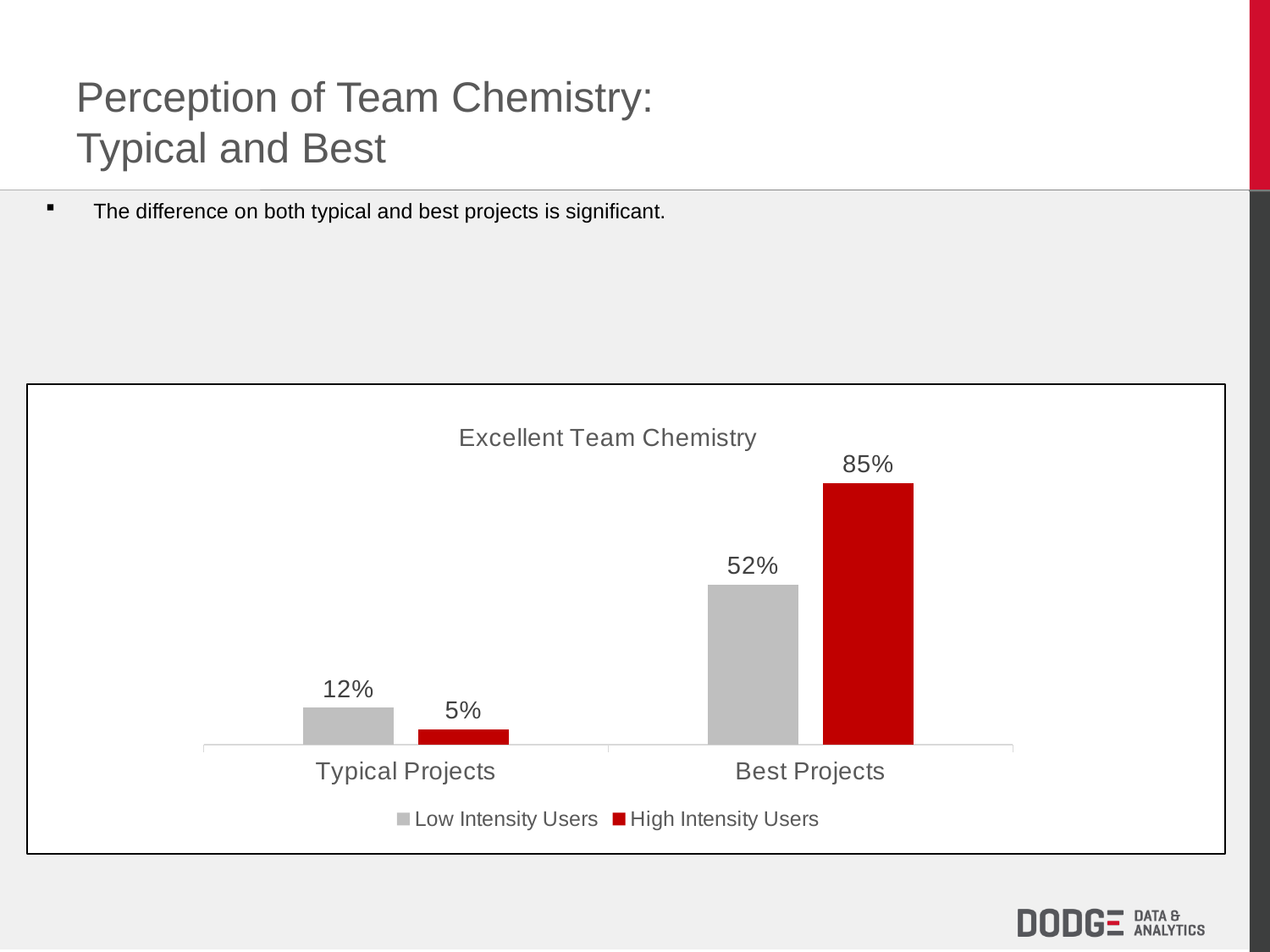
What is the value for Low Intensity Users on Best Projects? 52% What type of chart is shown on the slide? Bar chart What is the value for High Intensity Users on Typical Projects? 5% How many categories are shown on the x axis? 2 What is the difference between High Intensity Users and Low Intensity Users on Best Projects? 33% Which bar has the lowest value in the chart? High Intensity Users, Typical Projects What is the value for Low Intensity Users on Typical Projects? 12% On Typical Projects, which series has the larger value, Low Intensity Users or High Intensity Users? Low Intensity Users What is the difference between Low Intensity Users and High Intensity Users on Typical Projects? 7% What is the value for High Intensity Users on Best Projects? 85% How many series does the legend list? 2 Which bar has the highest value in the chart? High Intensity Users, Best Projects